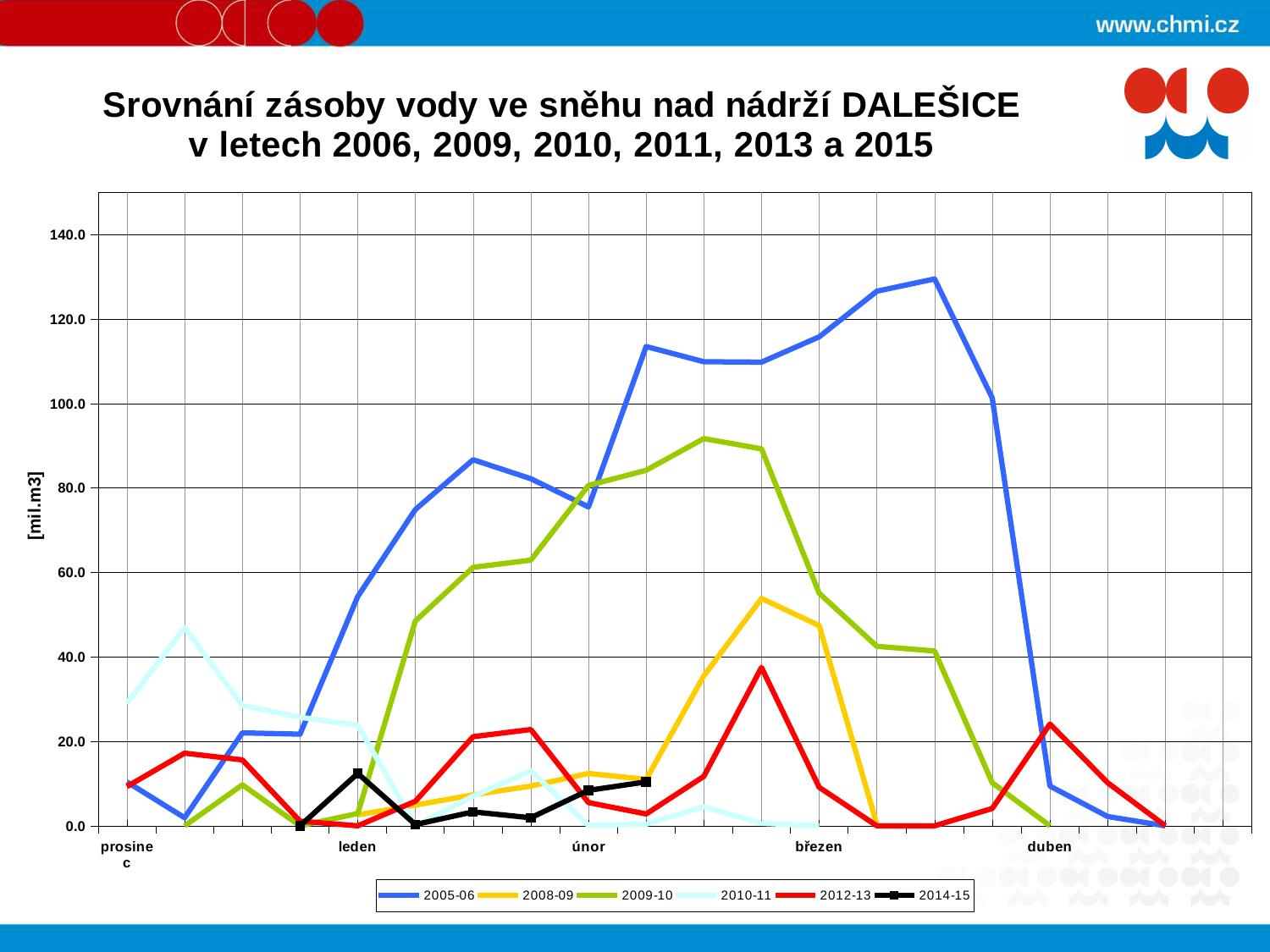
Is the peak value of the 2008-09 series greater or less than 40.0? greater How many series does the legend list? 6 What is the label of the y axis? [mil.m3] Is the peak value of the 2009-10 series greater or less than 100.0? less How many month labels are shown on the x axis? 5 Which series has the lowest peak value on the chart? 2014-15 Between březen and duben, does the 2005-06 line rise or fall? fall Is the peak value of the 2012-13 series greater or less than 60.0? less At březen, which series has the higher value, 2005-06 or 2009-10? 2005-06 Which series reaches the highest value on the chart? 2005-06 What kind of chart is shown on the slide? line chart